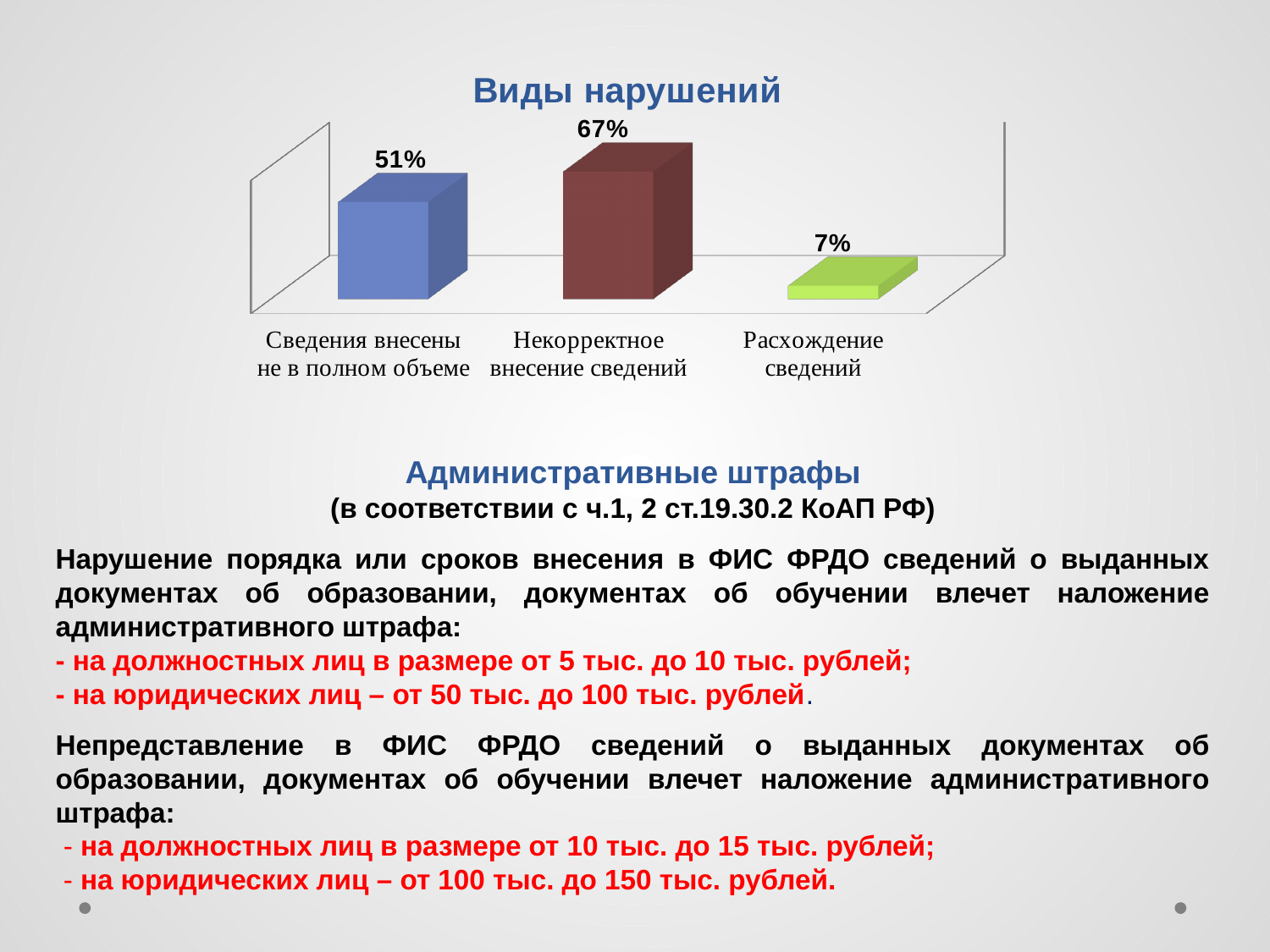
Which category has the highest value? Некорректное внесение сведений Which category has the lowest value? Расхождение сведений What is the value for "Сведения внесены не в полном объеме"? 51% What colour is the bar for "Расхождение сведений"? Green What is the difference between the values for "Некорректное внесение сведений" and "Сведения внесены не в полном объеме"? 16% What is the difference between the values for "Сведения внесены не в полном объеме" and "Расхождение сведений"? 44% What kind of chart is shown on the slide? Bar chart What is the title of the chart? Виды нарушений How many categories are shown in the chart? 3 Which is larger: the value for "Сведения внесены не в полном объеме" or for "Расхождение сведений"? Сведения внесены не в полном объеме What is the value for "Расхождение сведений"? 7% What is the value for "Некорректное внесение сведений"? 67%